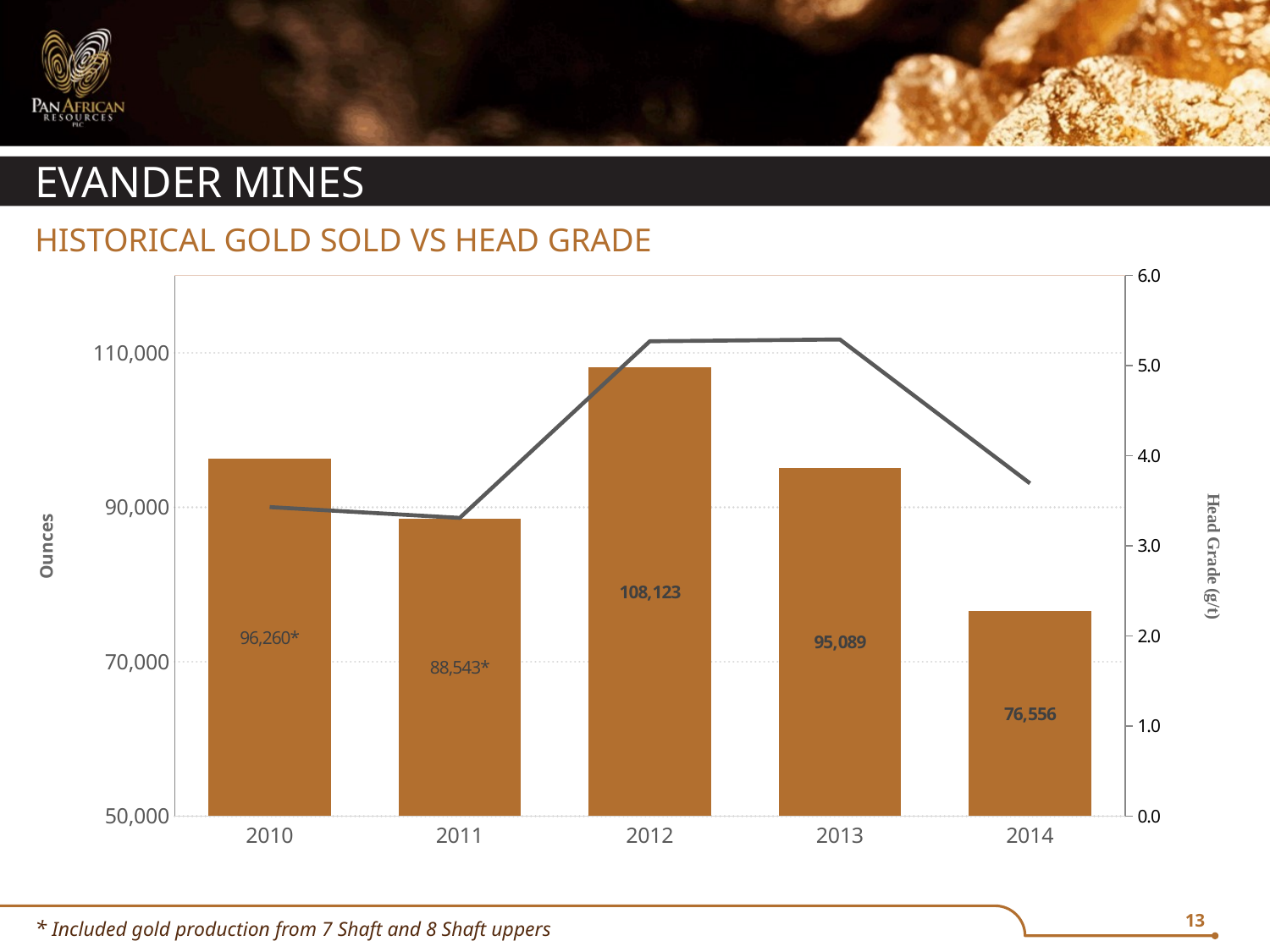
By how many ounces did gold sold in 2010 exceed gold sold in 2011? 7,717 How many years are shown on the x axis of the chart? 5 What is the difference in ounces sold between 2012 and 2013? 13,034 Did gold sold rise or fall from 2013 to 2014? fall How many ounces of gold were sold in 2012? 108,123 Is the head grade for 2012 greater or less than 5.0 g/t? greater Which year had more gold sold, 2011 or 2013? 2013 What is the title of the chart? HISTORICAL GOLD SOLD VS HEAD GRADE Is the head grade for 2014 greater or less than 4.0 g/t? less Which year has the lowest gold sold (ounces)? 2014 What is the gold sold value shown for 2014? 76,556 Which year has the highest gold sold (ounces)? 2012